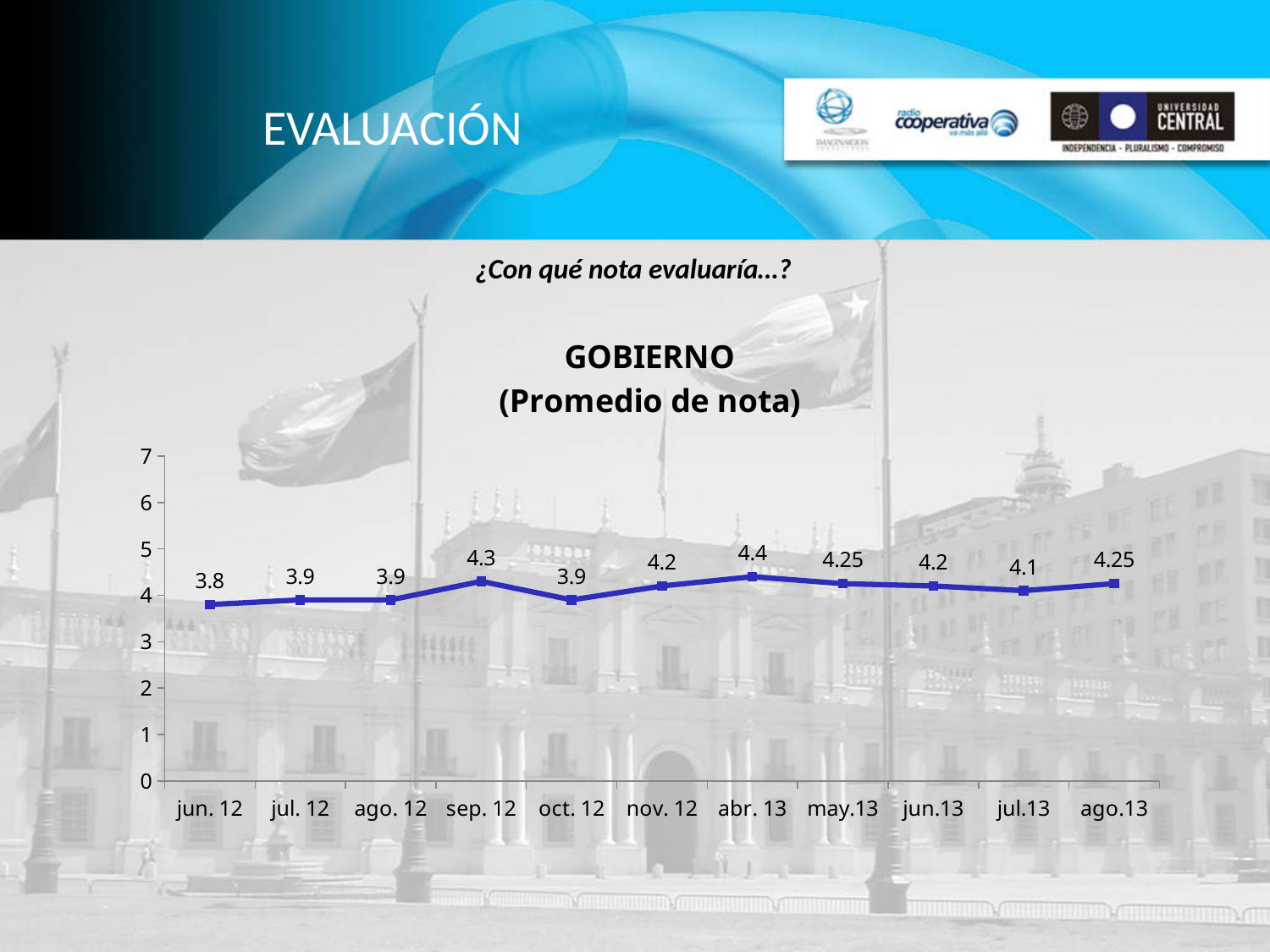
Which period has the highest value? abr. 13 Which is larger, the value for sep. 12 or the value for jul.13? sep. 12 What is the value for abr. 13? 4.4 Is the value for may.13 greater or less than 5? less What type of chart is shown on the slide? line chart What is the title of the chart? GOBIERNO (Promedio de nota) What is the value for ago.13? 4.25 Which period has the lowest value? jun. 12 What is the value for sep. 12? 4.3 How many periods are plotted on the x axis? 11 What is the value for jun. 12? 3.8 What is the difference between the values for abr. 13 and jun. 12? 0.6